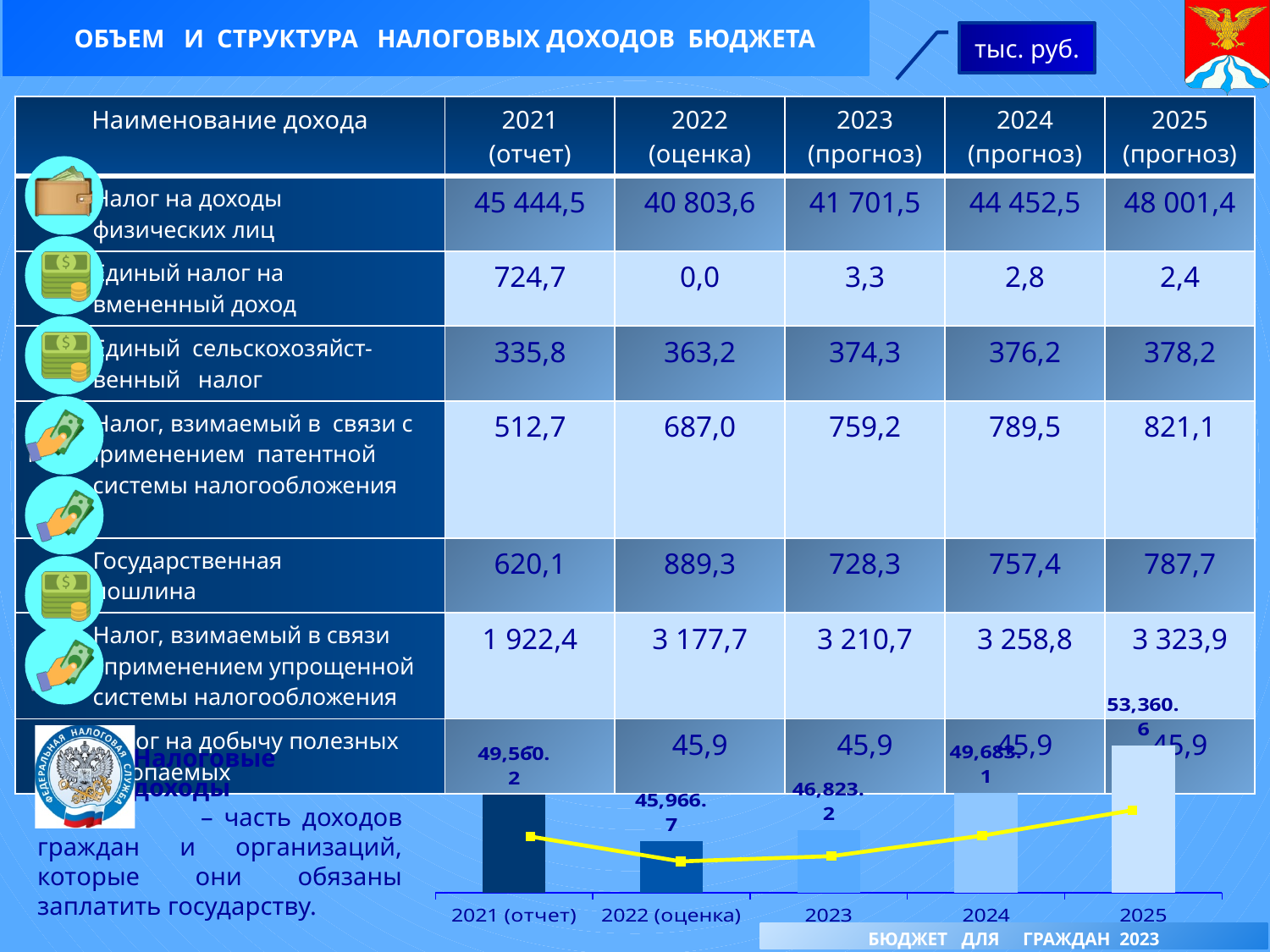
On the chart at the bottom of the slide, what is the difference between the 2023 value and the 2022 (оценка) value? 856.5 How many years (categories) are shown on the chart at the bottom of the slide? 5 On the chart at the bottom of the slide, what is the value for 2022 (оценка)? 45,966.7 On the chart at the bottom of the slide, do the values rise or fall from 2022 (оценка) to 2025? Rise On the chart at the bottom of the slide, which year has the highest value? 2025 On the chart at the bottom of the slide, what is the value for 2021 (отчет)? 49,560.2 On the chart at the bottom of the slide, what is the value for 2025? 53,360.6 On the chart at the bottom of the slide, what is the difference between the 2025 value and the 2021 (отчет) value? 3,800.4 On the chart at the bottom of the slide, what is the value for 2023? 46,823.2 On the chart at the bottom of the slide, which is larger: the value for 2022 (оценка) or the value for 2023? 2023 What kind of chart is shown at the bottom of the slide? Bar chart with a line overlay On the chart at the bottom of the slide, which year has the lowest value? 2022 (оценка)